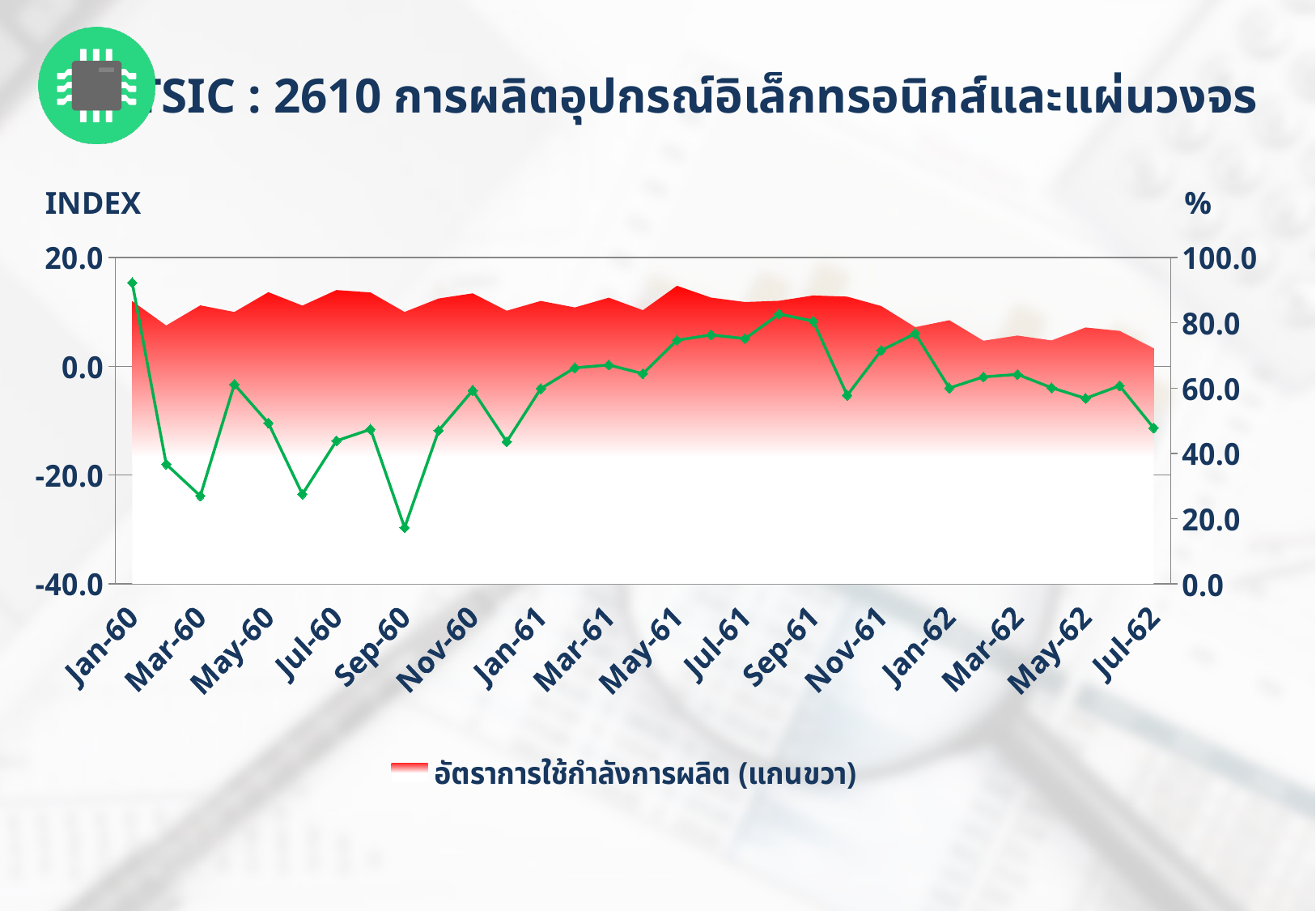
At which x-axis label does the green line reach its lowest point? Sep-60 How many series does the legend list? 1 What kind of chart is shown on the slide? A combination of a line chart and an area chart Is the green line value at Jul-62 greater or less than 0.0 on the left axis? less Which is larger on the green line: the value at Sep-61 or the value at Nov-61? Sep-61 Is the green line value at Jan-60 greater or less than 0.0 on the left axis? greater Is the green line value at Sep-60 greater or less than -20.0 on the left axis? less What is the label shown above the left axis? INDEX How many labels are shown on the x axis? 16 At which x-axis label does the green line reach its highest point? Jan-60